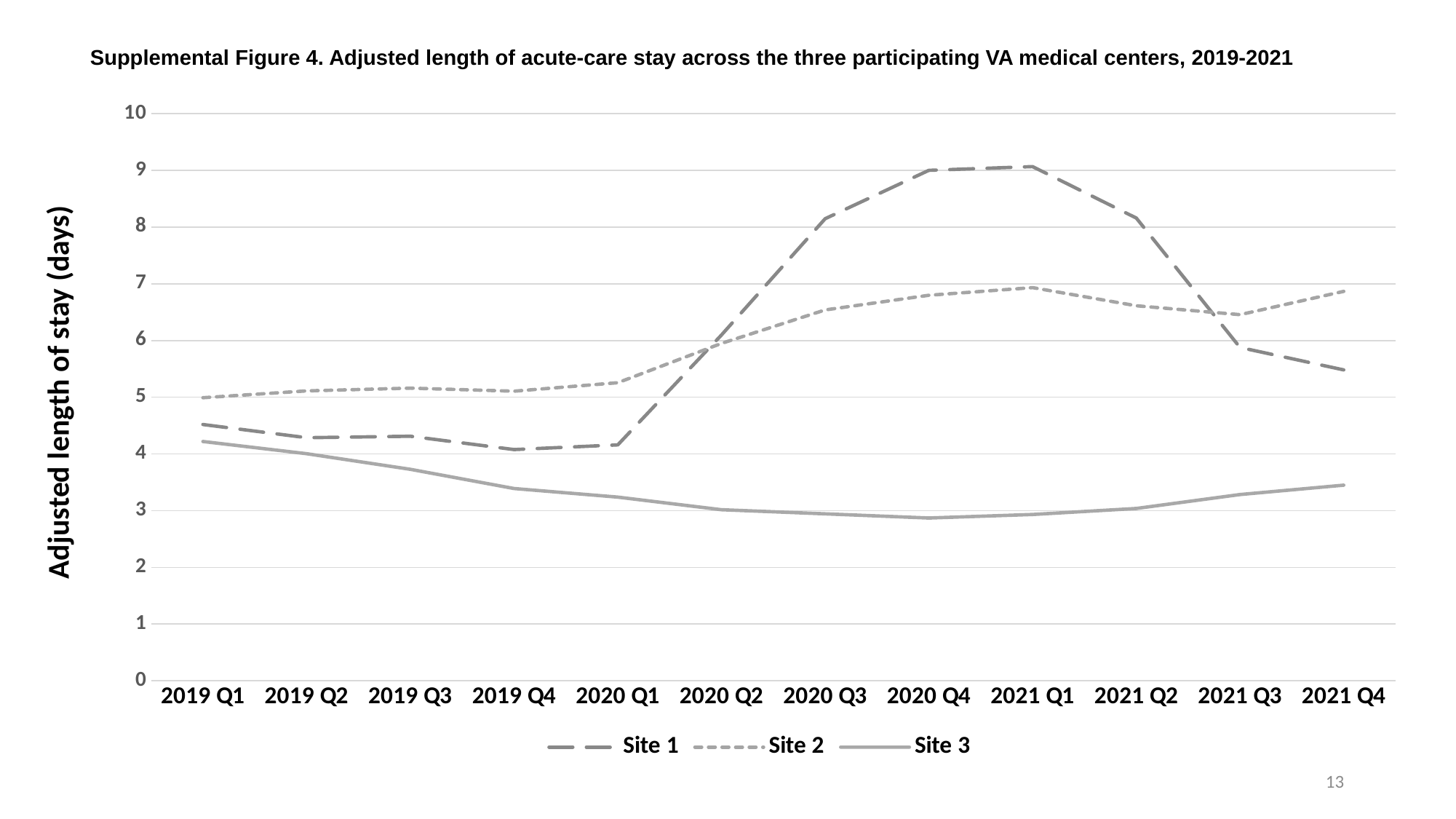
Which site has the highest value in 2021 Q3? Site 2 In 2020 Q4, which has the larger value, Site 1 or Site 2? Site 1 What is the title of the y axis? Adjusted length of stay (days) Is the value for Site 2 in 2021 Q4 greater or less than 6? greater Is the value for Site 1 in 2021 Q1 greater or less than 8? greater Which site has the lowest value in 2021 Q4? Site 3 How many series does the legend list? 3 In 2019 Q1, which has the larger value, Site 1 or Site 2? Site 2 Does the Site 3 line rise or fall from 2019 Q1 to 2020 Q4? fall Is the value for Site 3 in 2021 Q4 greater or less than 4? less How many quarters are shown along the x axis? 12 What kind of chart is shown on the slide? line chart